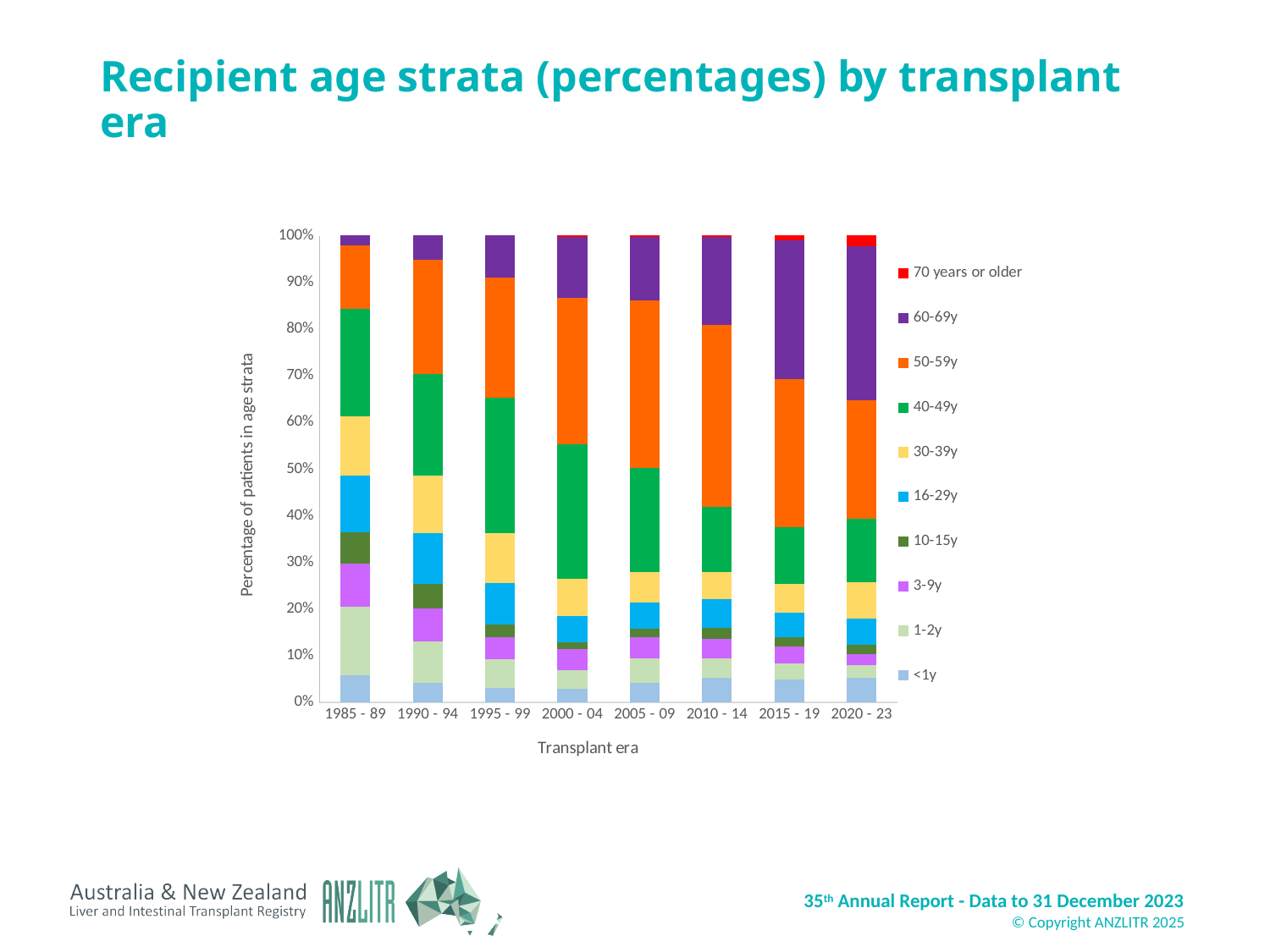
Is the share of the 60-69y stratum larger in the 1985 - 89 era or the 2020 - 23 era? 2020 - 23 In the 2020 - 23 era, is the share of the 40-49y stratum greater or less than 20%? less In the 1995 - 99 era, is the share of the 40-49y stratum greater or less than 20%? greater What kind of chart is shown on the slide? Stacked bar chart What is the label of the y axis? Percentage of patients in age strata In the 1985 - 89 era, is the share of the 50-59y stratum greater or less than 20%? less Does the share of the 60-69y age stratum rise or fall across the transplant eras from 1985 - 89 to 2020 - 23? Rises How many transplant eras are shown along the x axis? 8 What is the title of the chart? Recipient age strata (percentages) by transplant era How many age strata does the legend list? 10 Is the share of the 50-59y stratum larger in the 1985 - 89 era or the 2010 - 14 era? 2010 - 14 Does the share of the 16-29y age stratum rise or fall across the transplant eras from 1985 - 89 to 2020 - 23? Falls